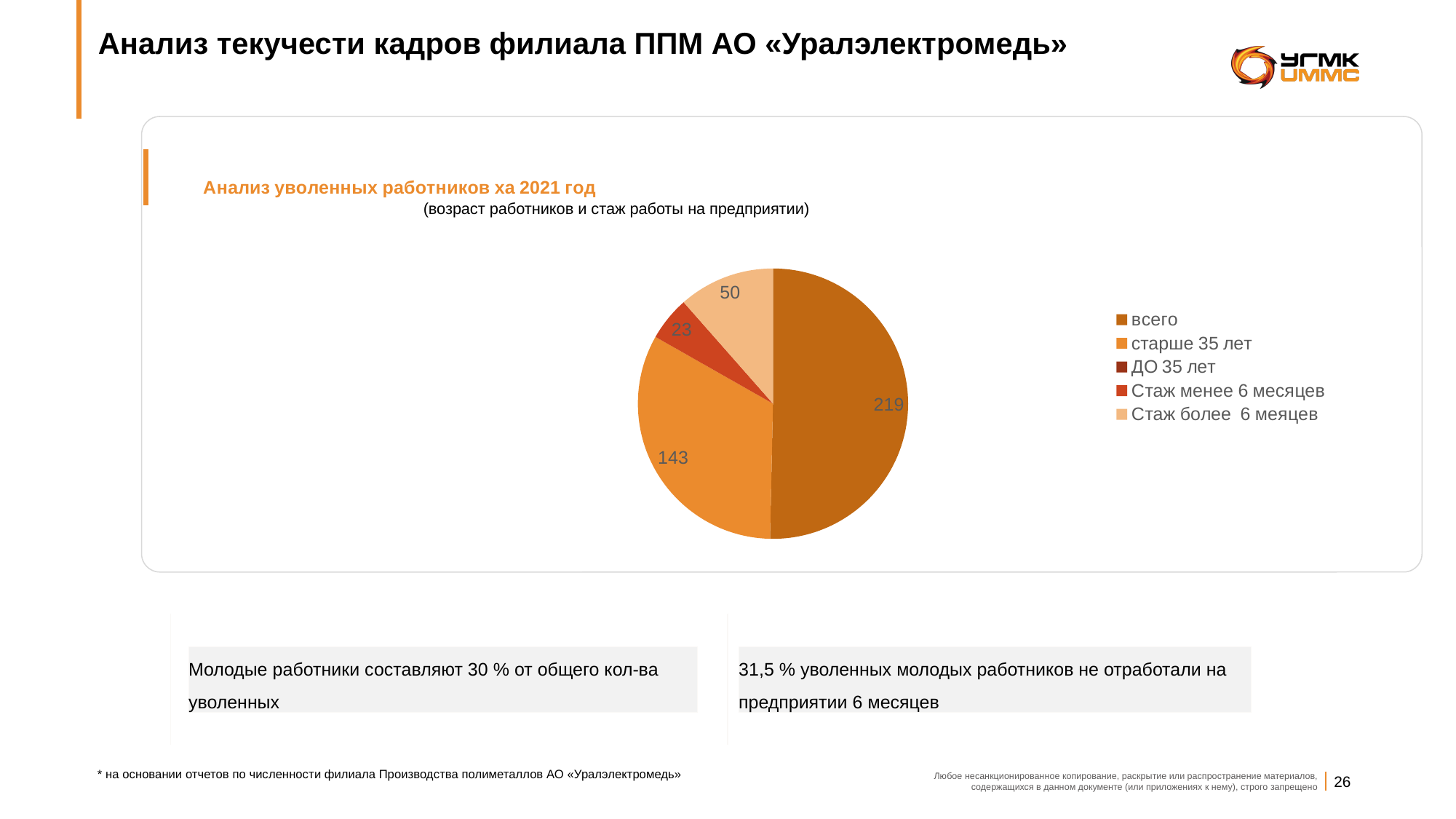
Which legend category has the largest slice in the pie chart? всего What value is shown for the 'старше 35 лет' slice of the pie chart? 143 What is the title of the chart on the slide? Анализ уволенных работников ха 2021 год What value is shown for the 'всего' slice of the pie chart? 219 Which is larger in the pie chart: the slice labelled 50 or the slice labelled 23? The slice labelled 50 How many data labels are printed on the pie chart? 4 What is the difference between the 'всего' value and the 'старше 35 лет' value in the pie chart? 76 How many entries does the legend of the pie chart list? 5 What value is shown for the 'Стаж более 6 меяцев' slice of the pie chart? 50 What is the smallest value labelled on the pie chart? 23 What is the difference between the 'старше 35 лет' value and the 'Стаж более 6 меяцев' value in the pie chart? 93 What kind of chart is shown on the slide? Pie chart